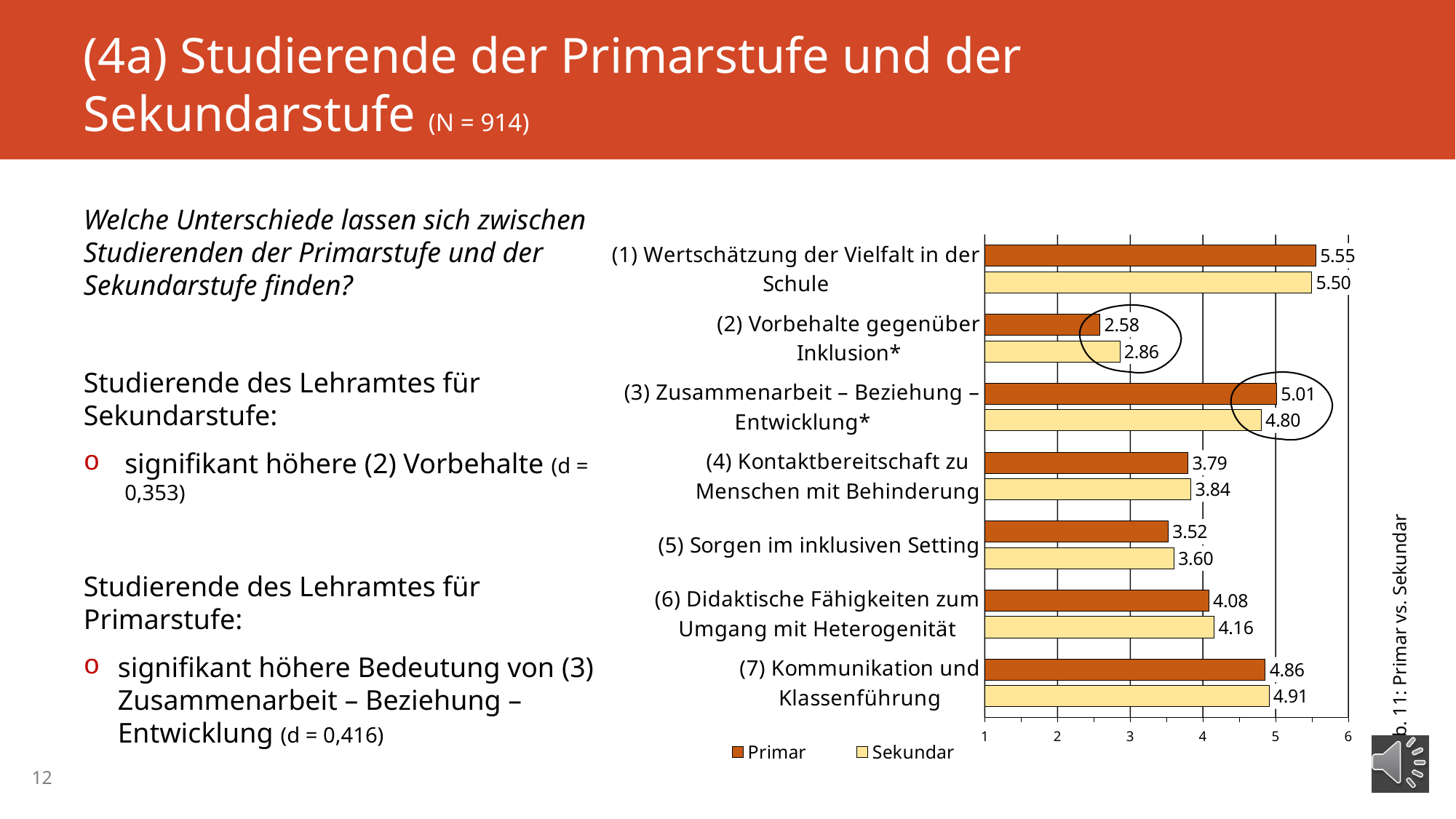
What kind of chart is shown on the slide? Bar chart What is the Sekundar value for (7) Kommunikation und Klassenführung? 4.91 For (6) Didaktische Fähigkeiten zum Umgang mit Heterogenität, which is larger, the Primar or the Sekundar value? Sekundar What is the Primar value for (1) Wertschätzung der Vielfalt in der Schule? 5.55 How many series does the legend list? 2 What is the difference between the Primar and Sekundar values for (3) Zusammenarbeit – Beziehung – Entwicklung*? 0.21 What is the Primar value for (3) Zusammenarbeit – Beziehung – Entwicklung*? 5.01 Which category has the lowest Primar value? (2) Vorbehalte gegenüber Inklusion* Which category has the highest Sekundar value? (1) Wertschätzung der Vielfalt in der Schule What is the difference between the Sekundar and Primar values for (2) Vorbehalte gegenüber Inklusion*? 0.28 What is the Sekundar value for (2) Vorbehalte gegenüber Inklusion*? 2.86 How many categories are shown on the chart? 7